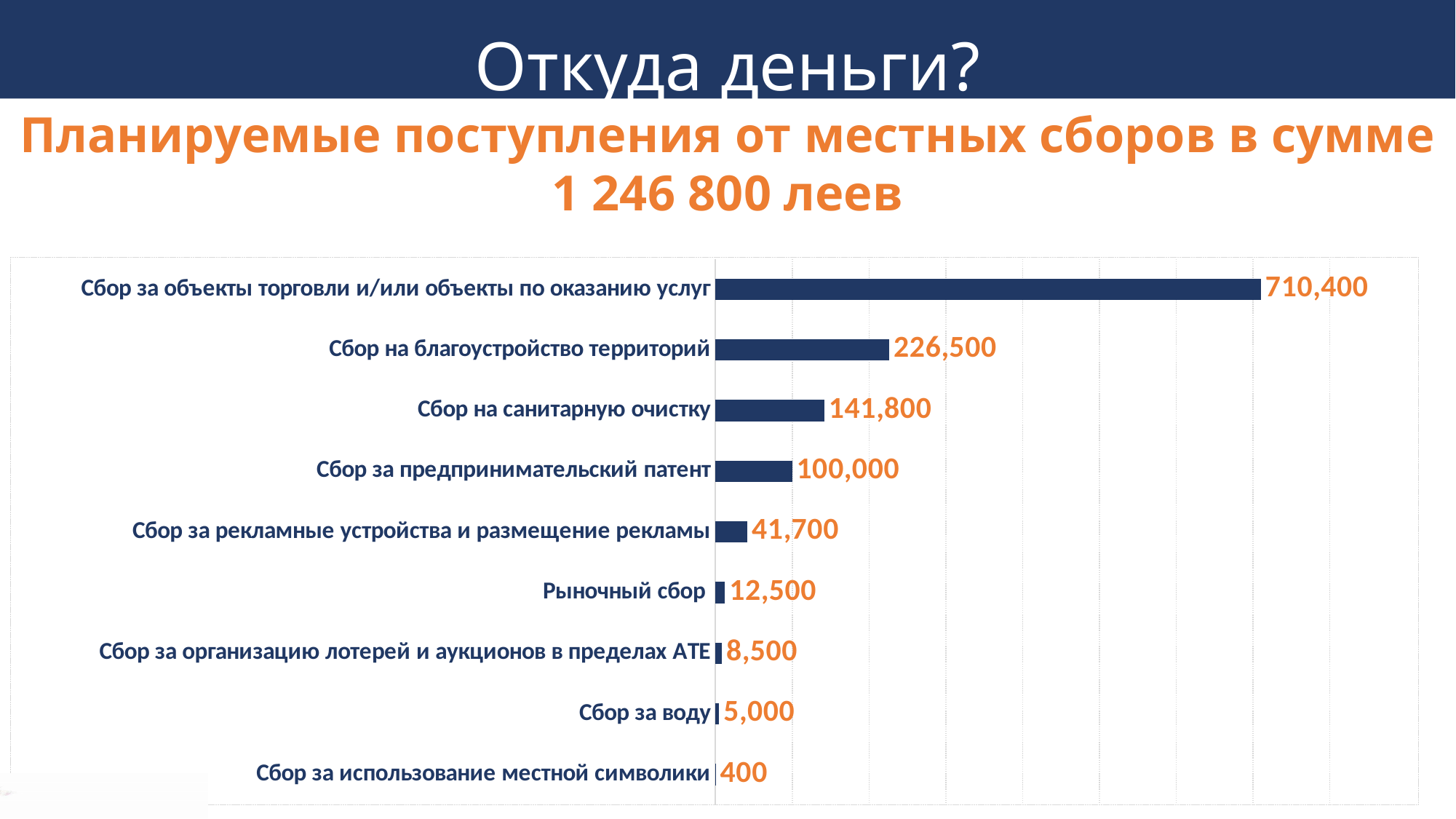
What is the value for Сбор за рекламные устройства и размещение рекламы? 41,700 What is the value for Сбор за объекты торговли и/или объекты по оказанию услуг? 710,400 What total sum of planned local fee revenue is stated in the slide heading? 1 246 800 леев What kind of chart is shown on the slide? Bar chart What is the value for Сбор за воду? 5,000 Which category has the highest value? Сбор за объекты торговли и/или объекты по оказанию услуг Which category has the lowest value? Сбор за использование местной символики What is the difference between the values for Сбор на благоустройство территорий and Сбор на санитарную очистку? 84,700 What is the value for Сбор на благоустройство территорий? 226,500 How many categories are shown in the chart? 9 What is the difference between the values for Рыночный сбор and Сбор за организацию лотерей и аукционов в пределах АТЕ? 4,000 Which is larger: the value for Сбор за предпринимательский патент or the value for Сбор на санитарную очистку? Сбор на санитарную очистку